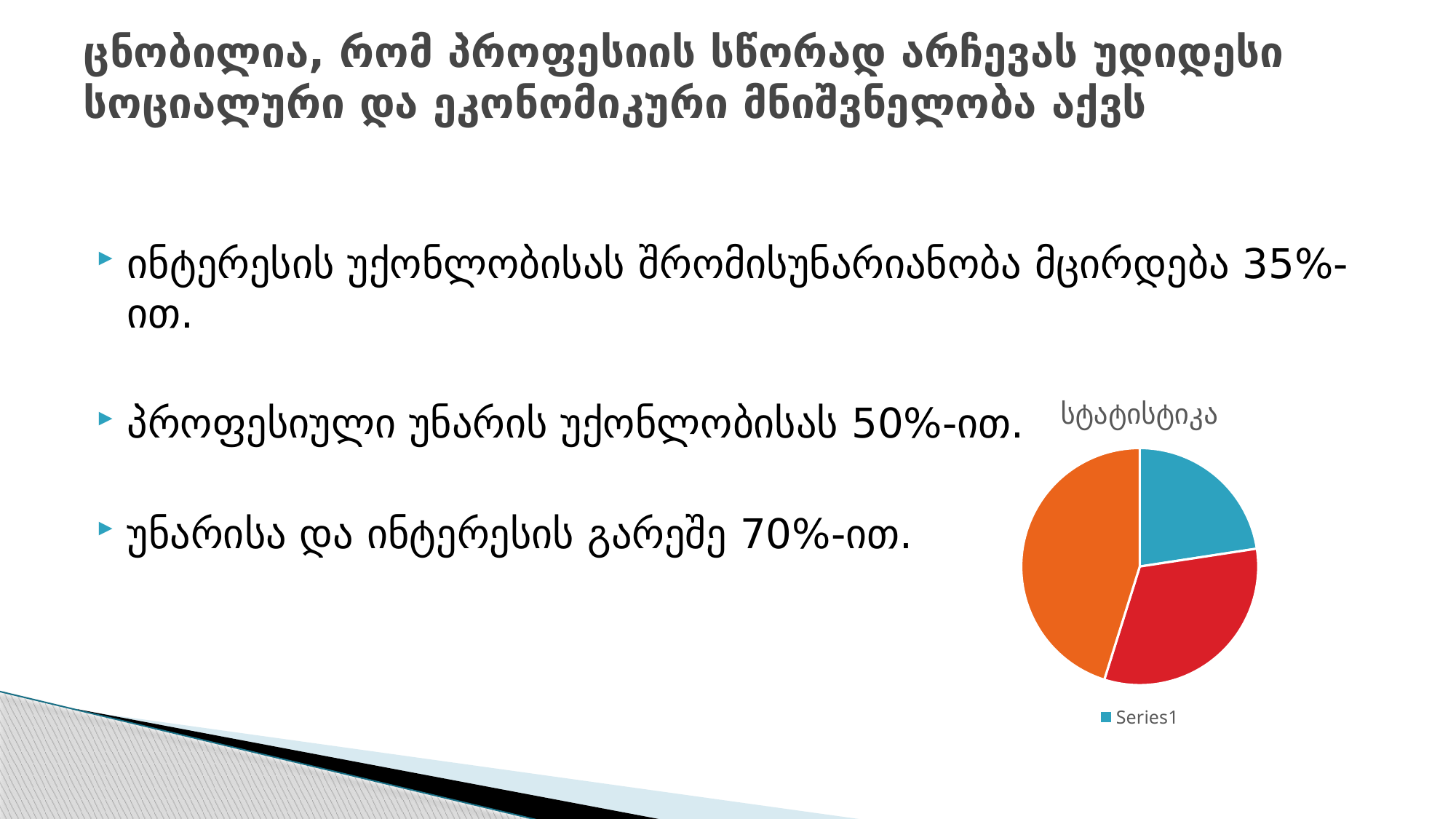
What is the title of the pie chart? სტატისტიკა Which is larger in the pie chart, the red slice or the blue slice? red What kind of chart is shown on the slide? pie chart What is the legend entry shown below the pie chart? Series1 Which colour slice is the smallest in the pie chart? blue How many slices does the pie chart have? 3 Which colour slice is the largest in the pie chart? orange How many series does the chart legend list? 1 Which is larger in the pie chart, the orange slice or the blue slice? orange